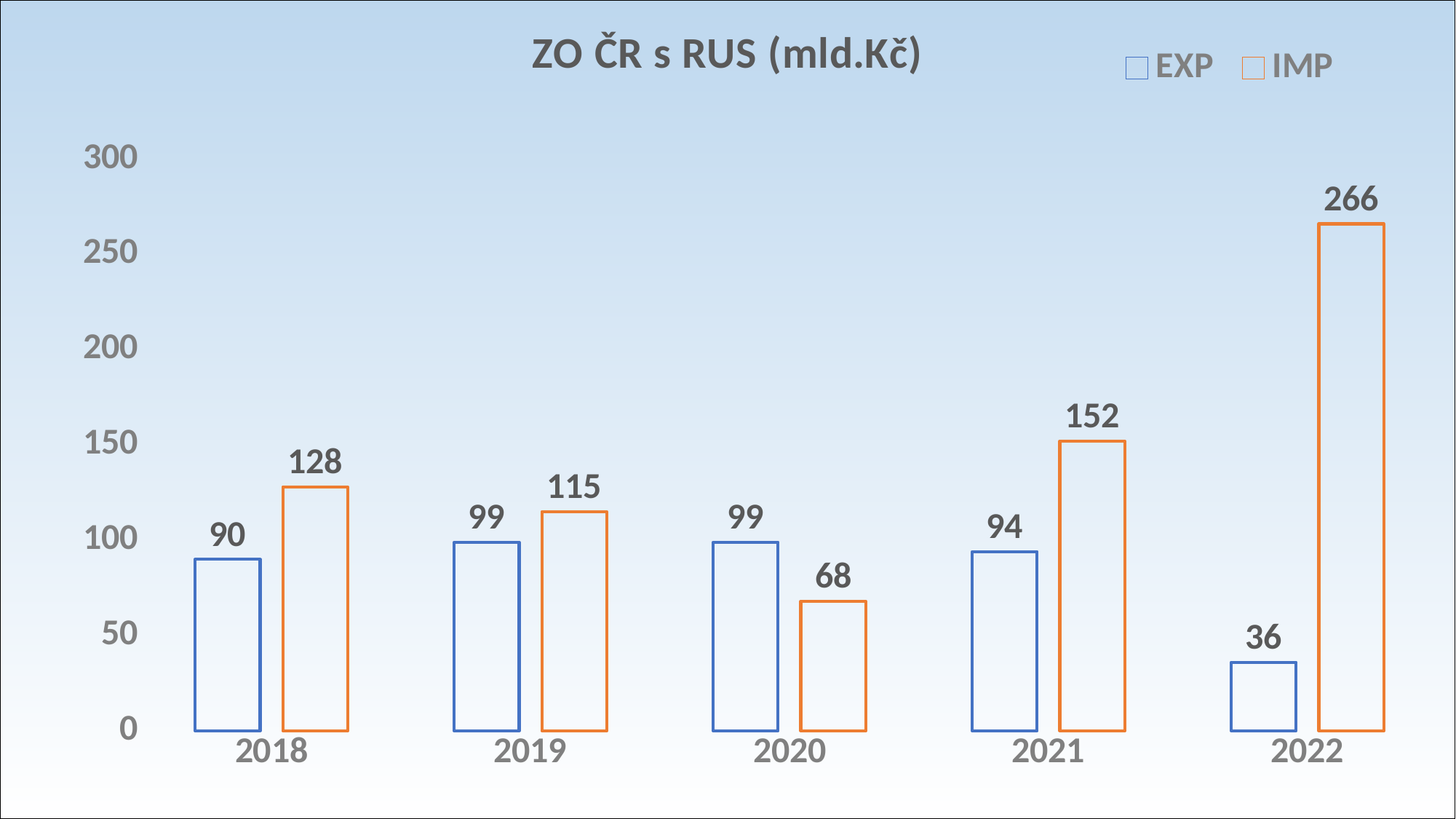
Which year has the lowest EXP value? 2022 How many years are shown on the x axis? 5 What kind of chart is shown? bar chart What is the IMP value for 2020? 68 What is the difference between IMP and EXP in 2021? 58 What is the EXP value for 2018? 90 Is the IMP value for 2022 greater or less than 250? greater What is the IMP value for 2022? 266 Which year has the highest IMP value? 2022 What is the title of the chart? ZO ČR s RUS (mld.Kč) Which is larger in 2020, EXP or IMP? EXP How many series does the legend list? 2